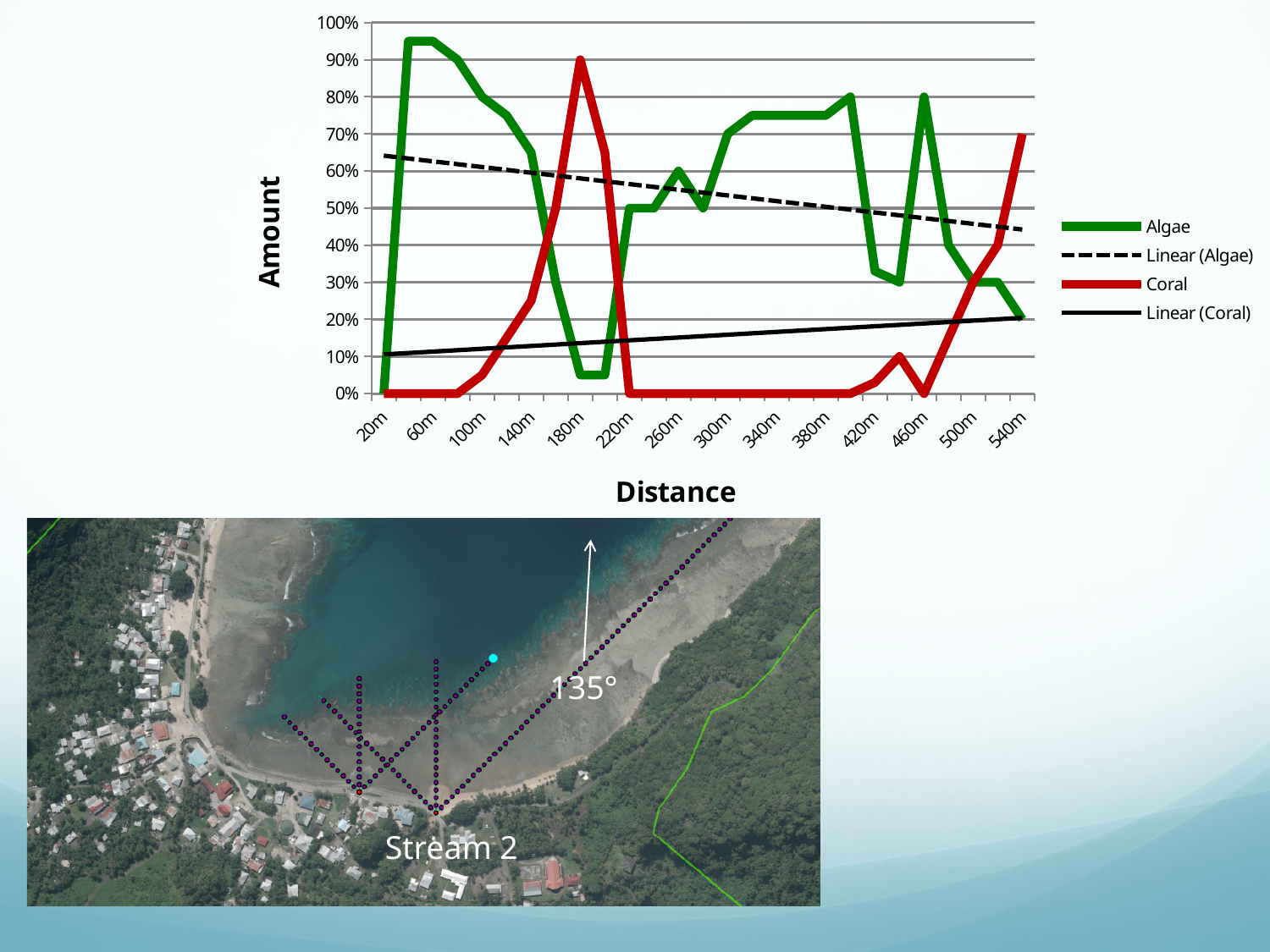
What is the title of the vertical axis? Amount At 60m, which series has the larger value, Algae or Coral? Algae At 180m, which series has the larger value, Algae or Coral? Coral Is the Algae value at 340m greater or less than 70%? greater Is the Algae value at 60m greater or less than 90%? greater What kind of chart is shown on the slide? line chart What colour is the Coral line in the chart? red Does the Linear (Algae) trendline rise or fall as distance increases? fall Is the Coral value at 300m greater or less than 10%? less How many series does the chart legend list? 4